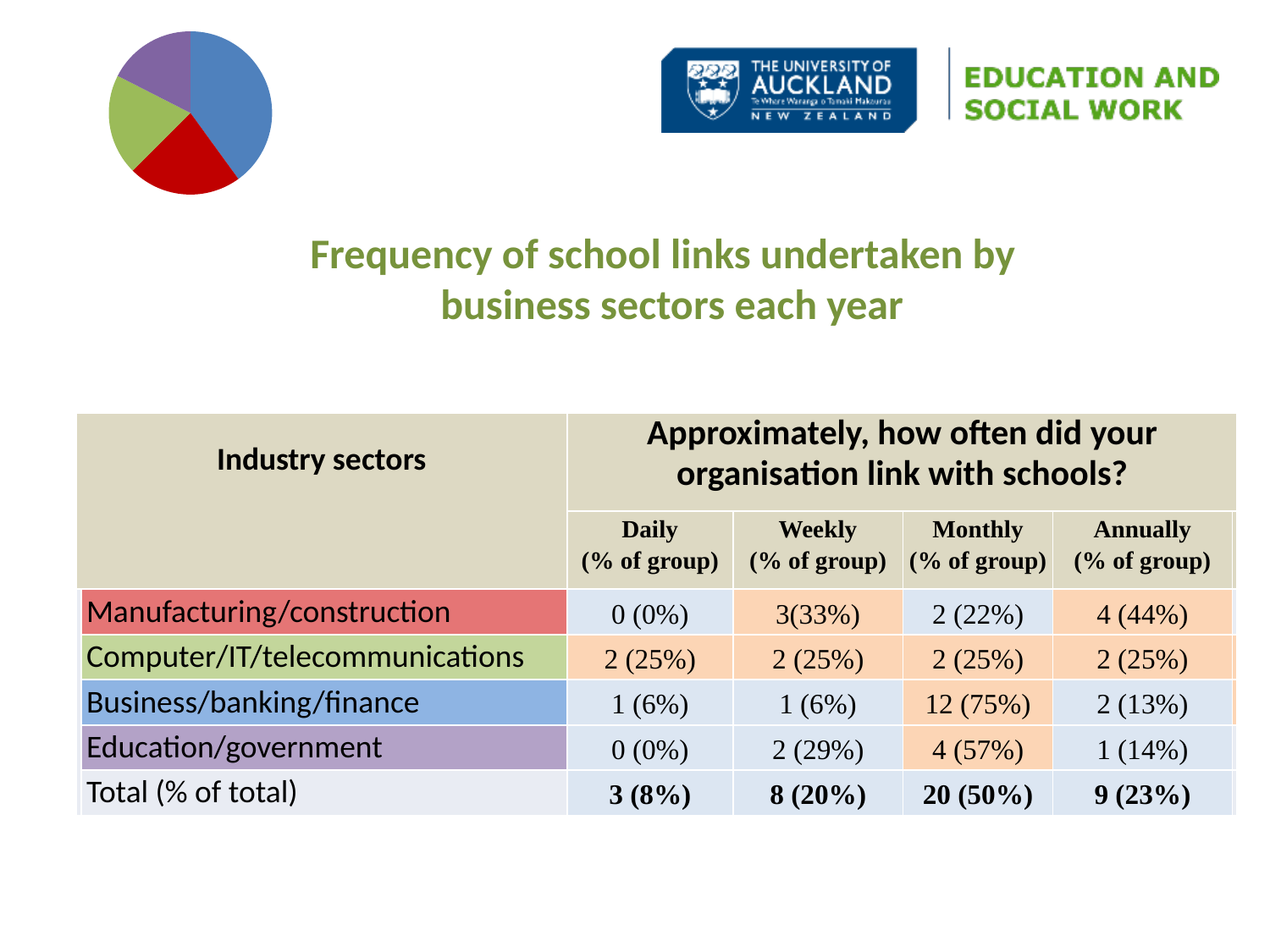
Does the pie chart in the top-left corner show any data labels or a legend? No How many slices does the pie chart in the top-left corner have? 4 In the pie chart in the top-left corner, which colour slice is the largest? blue In the pie chart in the top-left corner, is the purple slice larger or smaller than the blue slice? smaller In the pie chart in the top-left corner, is the blue slice larger or smaller than the red slice? larger In the pie chart in the top-left corner, is the blue slice greater or less than half of the pie? less What four colours are used for the slices of the pie chart in the top-left corner? blue, red, green, purple What kind of chart is shown in the top-left corner of the slide? pie chart